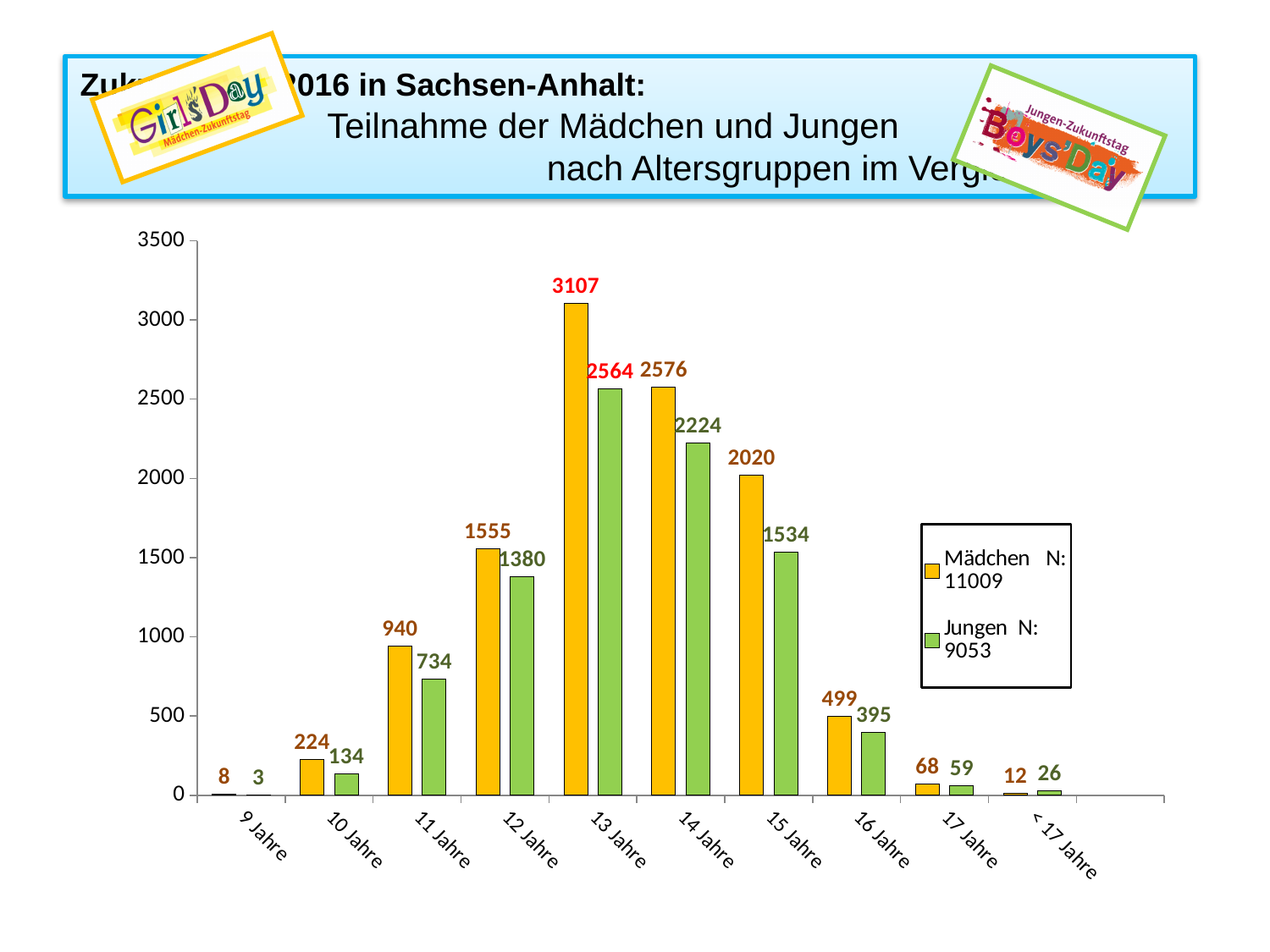
Which age group has the lowest value for Jungen? 9 Jahre What is the difference between Mädchen and Jungen in the 12 Jahre age group? 175 Which is larger in the 16 Jahre age group, Mädchen or Jungen? Mädchen What is the value for Jungen in the 9 Jahre age group? 3 Which is larger in the < 17 Jahre age group, Mädchen or Jungen? Jungen What is the value for Mädchen in the 13 Jahre age group? 3107 How many series does the legend list? 2 What colour are the Jungen bars? Green What kind of chart is shown on the slide? Bar chart Which age group has the highest value for Mädchen? 13 Jahre What is the value for Jungen in the 14 Jahre age group? 2224 How many age groups are shown on the x axis? 10